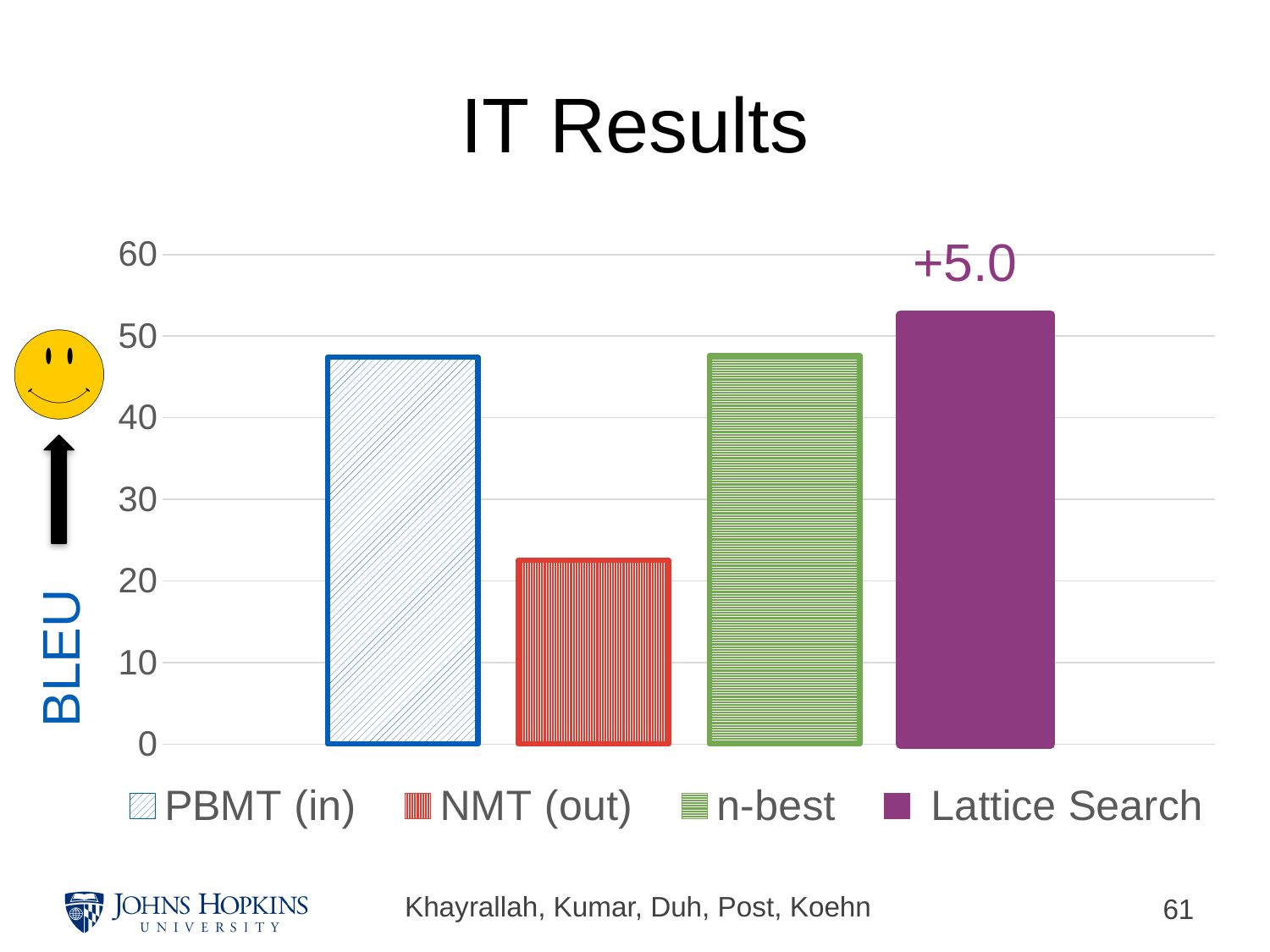
How many entries does the legend list? 4 Which system has the highest BLEU score? Lattice Search What kind of chart is shown on the slide? bar chart What annotation is printed above the Lattice Search bar? +5.0 Is the BLEU value for NMT (out) greater or less than 30? less Is the BLEU value for n-best greater or less than 50? less How many bars are plotted in the chart? 4 Is the BLEU value for PBMT (in) greater or less than 40? greater What label is shown on the vertical axis? BLEU Which has a higher BLEU score, Lattice Search or NMT (out)? Lattice Search Which system has the lowest BLEU score? NMT (out)